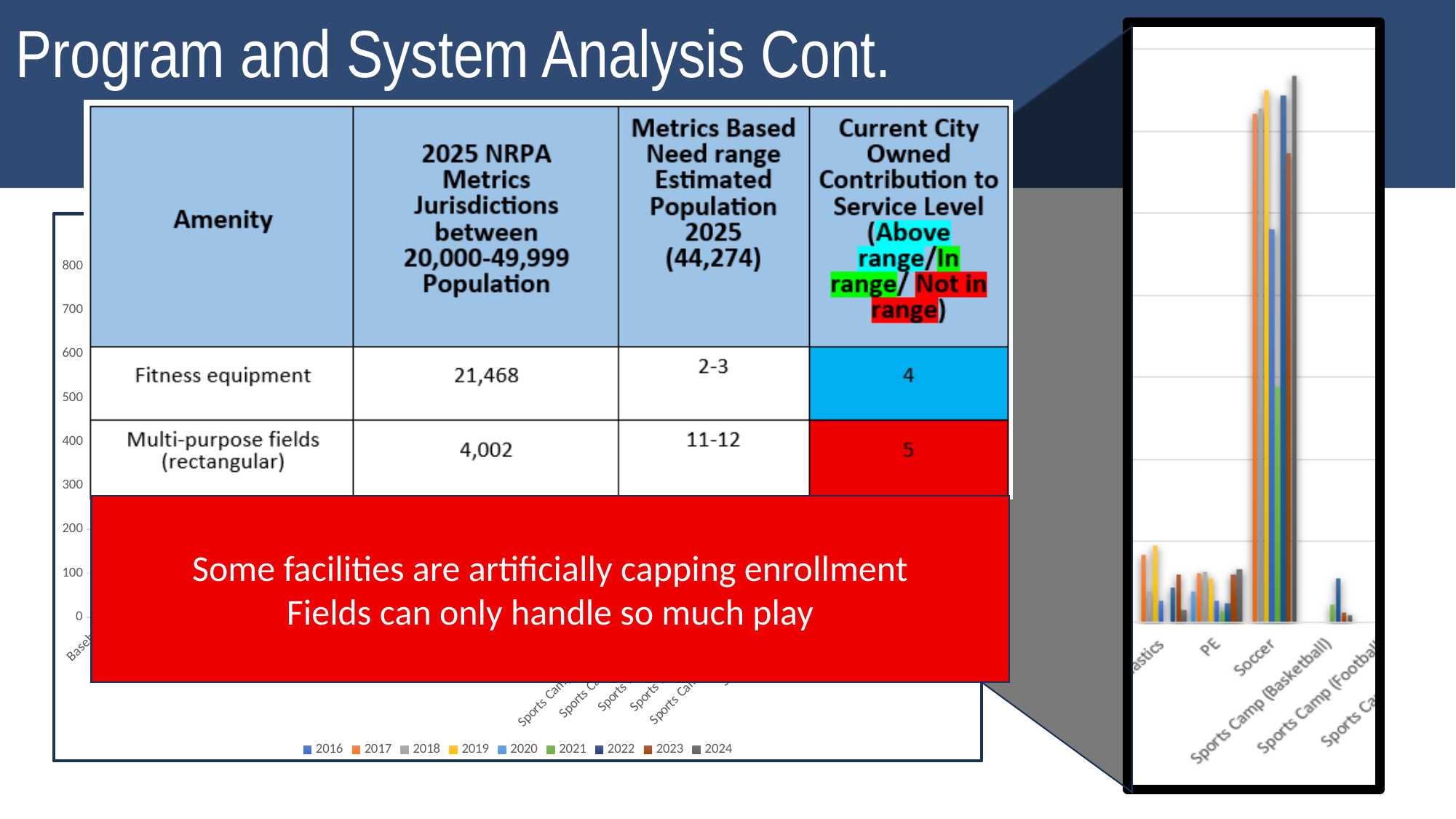
In the enlarged portion of the chart on the right, which category has the tallest bars? Soccer In the enlarged portion of the chart on the right, which category has taller bars, Soccer or Sports Camp (Basketball)? Soccer How many series does the chart's legend list? 9 What is the last year listed in the chart's legend? 2024 In the enlarged portion of the chart on the right, which category has taller bars, Soccer or PE? Soccer What is the first year listed in the chart's legend? 2016 What kind of chart is shown on the slide? bar chart What is the highest value shown on the chart's vertical axis? 800